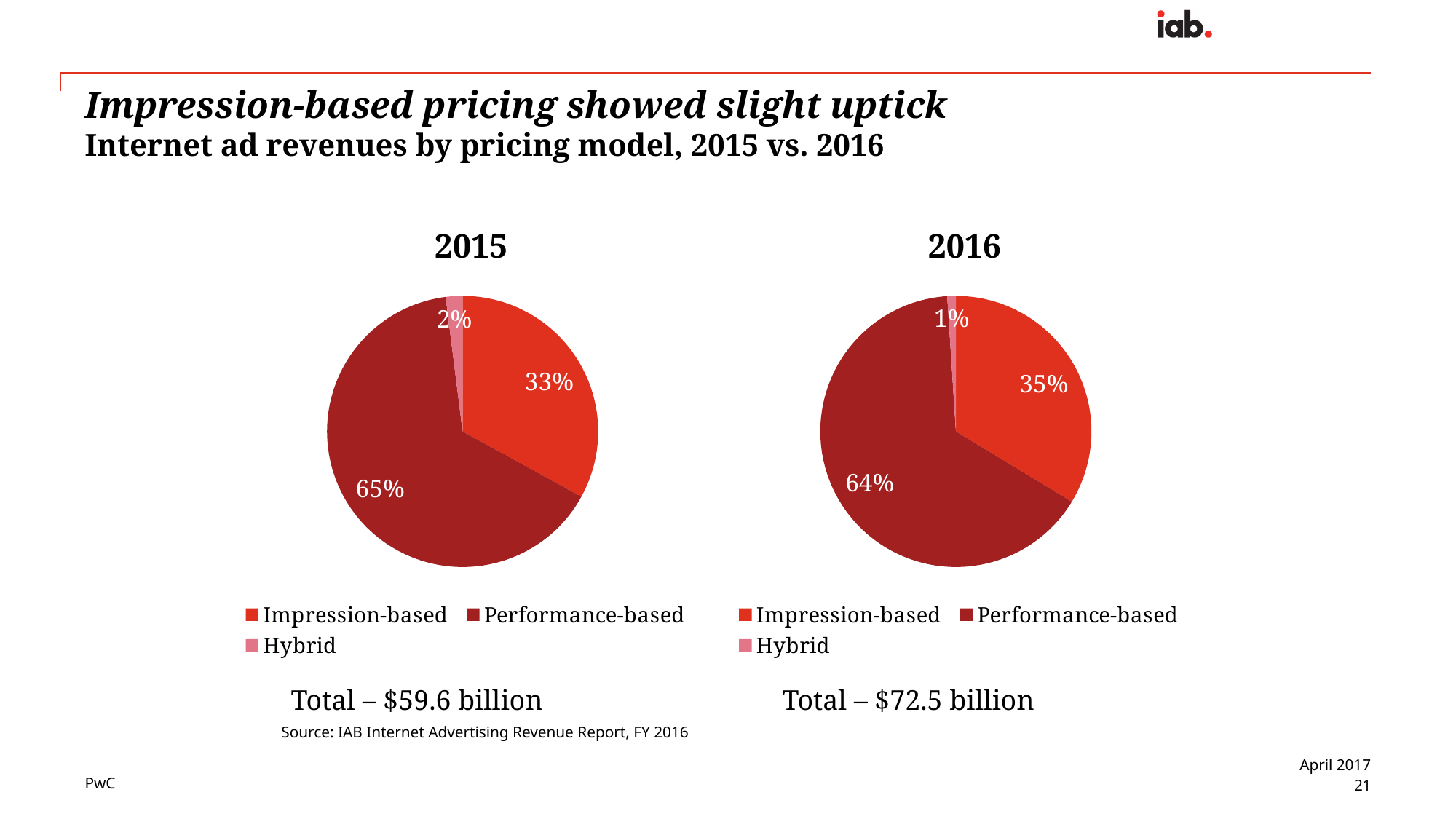
In the 2016 pie chart, what share of internet ad revenues was Performance-based? 64% What type of chart is used to show the 2015 revenues by pricing model? Pie chart In the 2015 pie chart, what share does Hybrid pricing have? 2% In the 2015 pie chart, which pricing model has the smallest share? Hybrid How many entries does the legend of the 2015 pie chart list? 3 In the 2015 pie chart, what share of internet ad revenues was Impression-based? 33% What total revenue is shown beneath the 2016 pie chart? $72.5 billion In the 2015 pie chart, what is the difference in percentage points between the Performance-based and Impression-based shares? 32 How many slices does the 2016 pie chart have? 3 Is the Impression-based share larger in the 2015 pie chart or the 2016 pie chart? 2016 In the 2016 pie chart, what share does Hybrid pricing have? 1% In the 2016 pie chart, which pricing model has the largest share? Performance-based